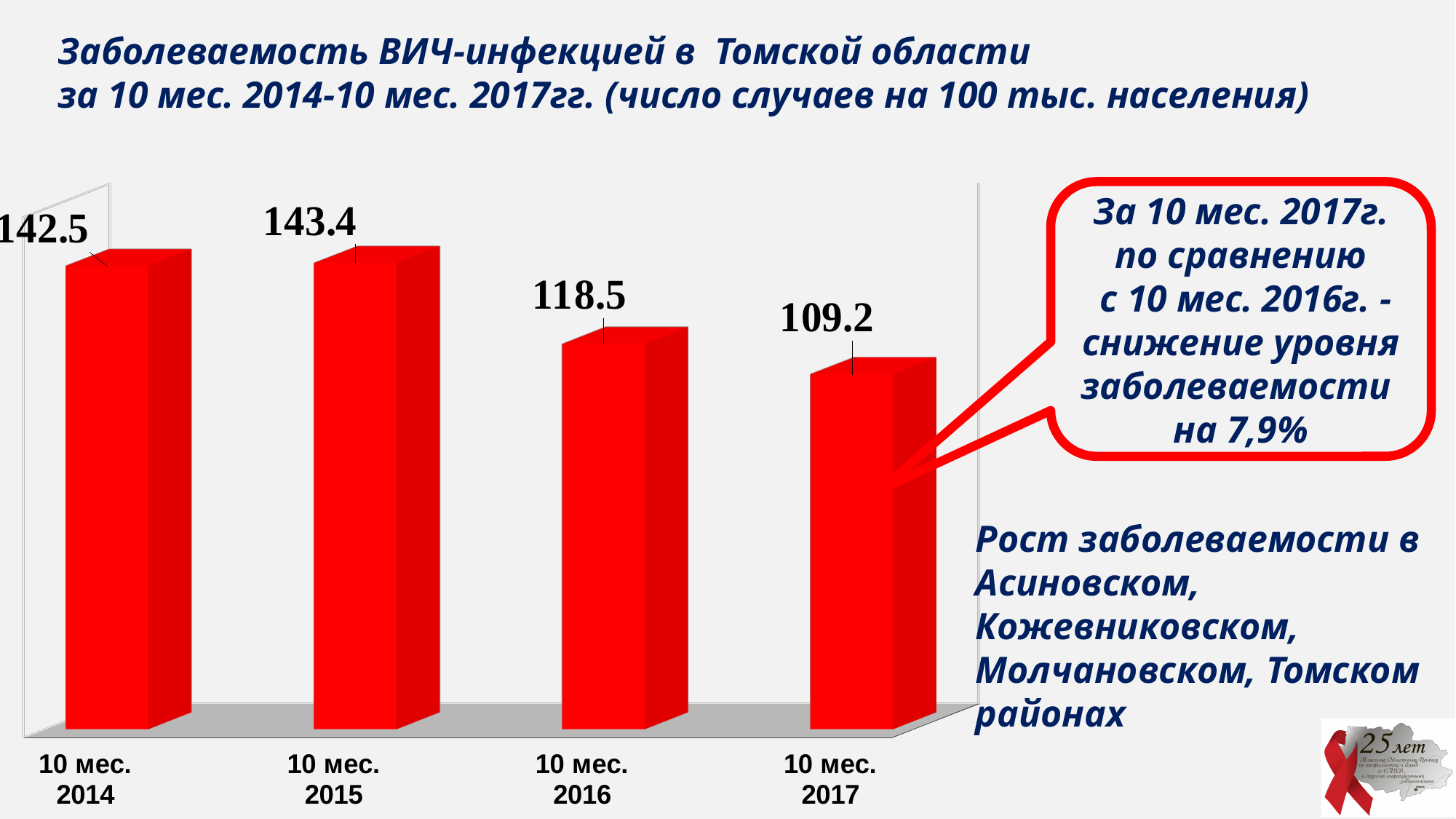
What is the HIV incidence value for 10 мес. 2015? 143.4 Which period has the highest HIV incidence value? 10 мес. 2015 What kind of chart is shown on the slide? Bar chart What is the HIV incidence value for 10 мес. 2014? 142.5 What is the difference between the values for 10 мес. 2015 and 10 мес. 2016? 24.9 What is the difference between the values for 10 мес. 2016 and 10 мес. 2017? 9.3 What is the HIV incidence value for 10 мес. 2016? 118.5 Which period has the lowest HIV incidence value? 10 мес. 2017 What is the HIV incidence value for 10 мес. 2017? 109.2 How many periods (bars) are shown in the chart? 4 Do the values generally rise or fall from 10 мес. 2015 to 10 мес. 2017? Fall Which is larger, the value for 10 мес. 2014 or the value for 10 мес. 2016? 10 мес. 2014